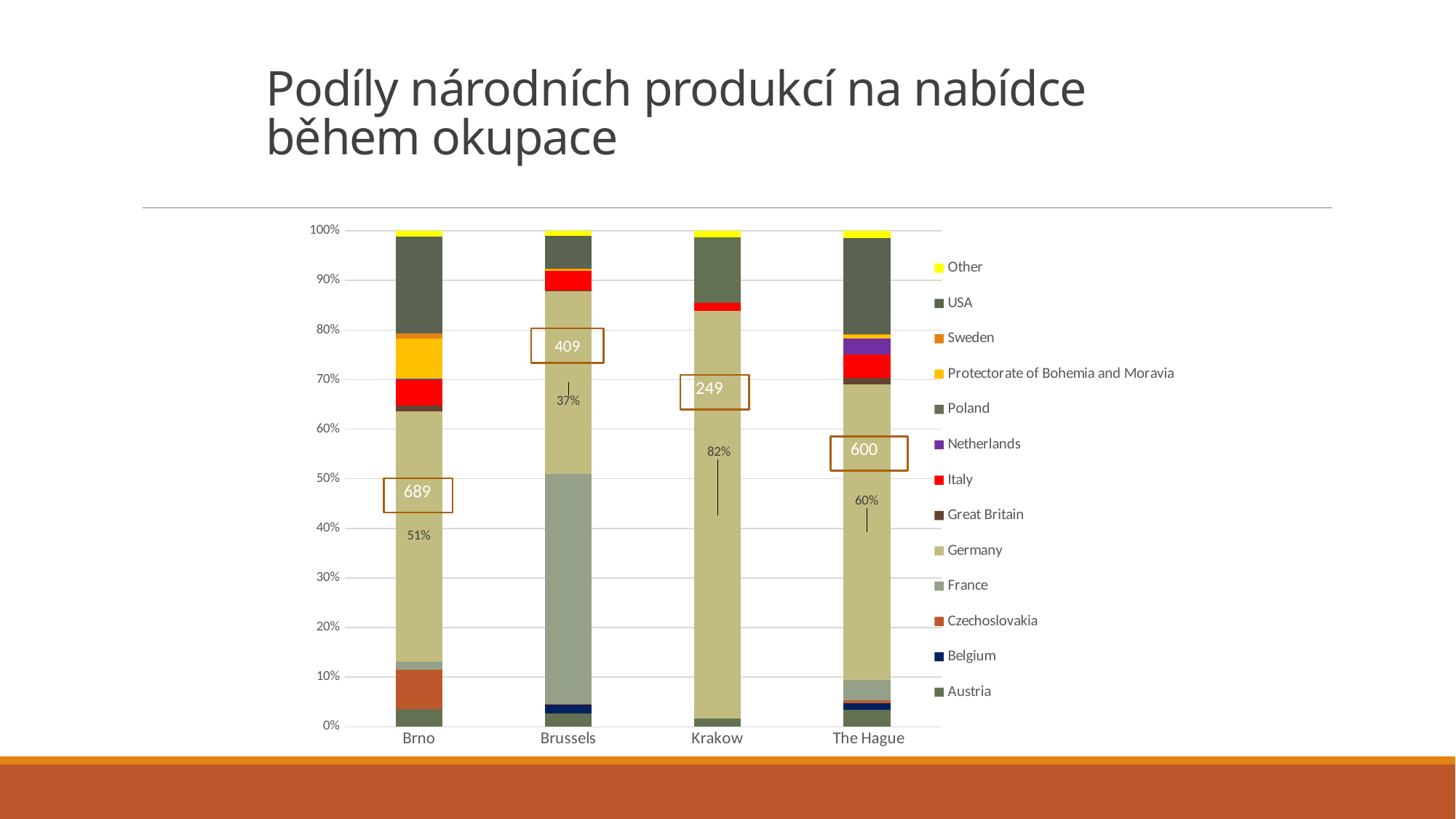
What is the labelled share of Germany in the Brussels bar? 37% Which city has the highest labelled share for Germany? Krakow Which has a larger labelled Germany share, Brno or The Hague? The Hague How many cities are shown on the x axis of the chart? 4 Which city has the lowest labelled share for Germany? Brussels What kind of chart is shown on the slide? stacked bar chart What is the labelled share of Germany in the Krakow bar? 82% How many series does the chart's legend list? 13 Is the France segment in the Brussels bar greater or less than 40%? greater What is the labelled share of Germany in the Brno bar? 51% What number is shown in the box on the Brussels bar? 409 What is the difference between the labelled Germany share in Krakow and in Brussels? 45%